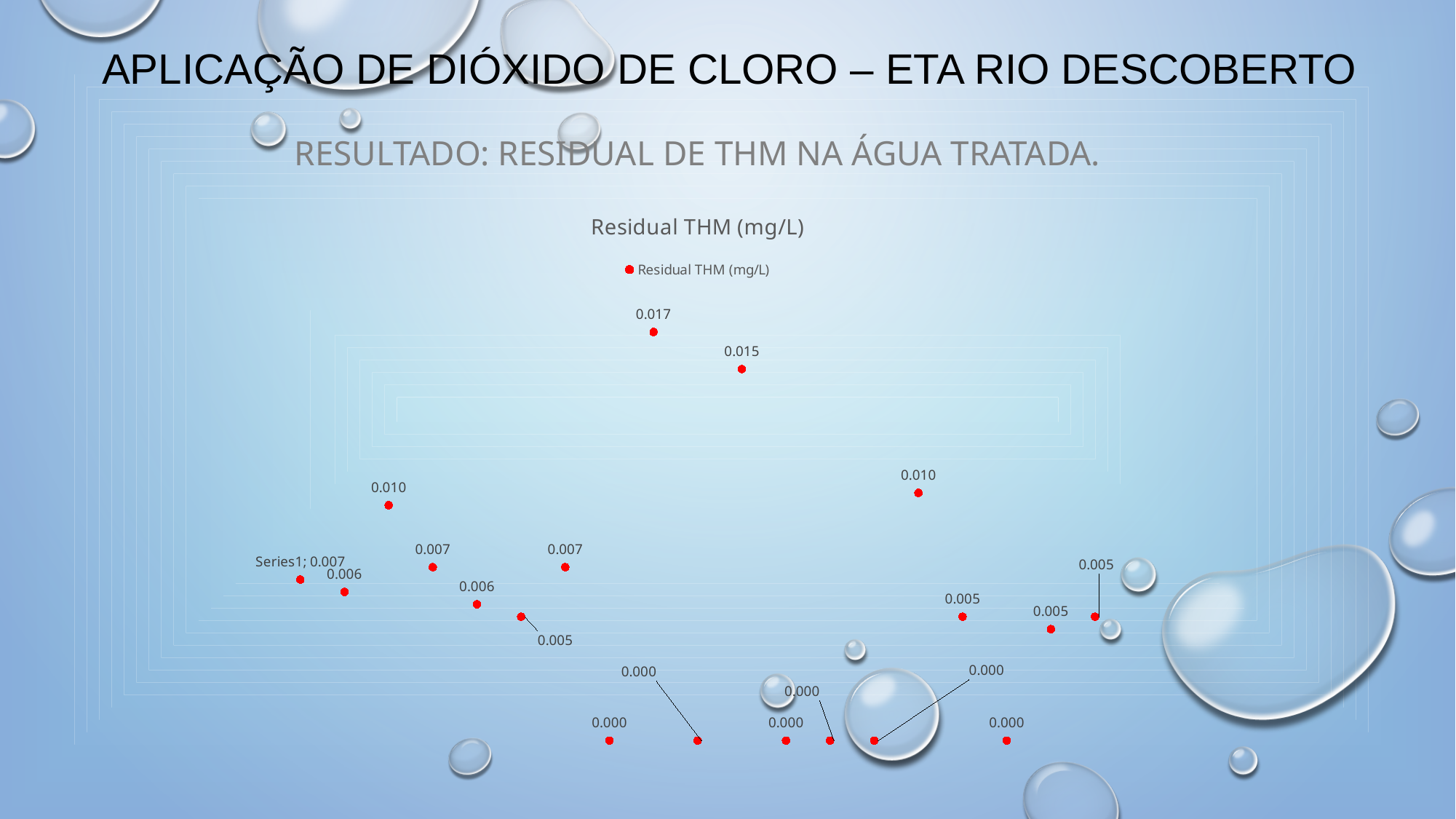
How many series does the chart legend list? 1 What is the lowest value plotted on the chart? 0.000 What is the difference between the highest value (0.017) and the second highest value (0.015) on the chart? 0.002 What is the title of the chart? Residual THM (mg/L) How many data points are plotted on the chart? 19 How many data points on the chart are labelled 0.000? 6 What value is shown for the point labelled 'Series1' on the chart? 0.007 Which is larger: the value of the first point on the left (0.007) or the value of the last point on the right (0.005)? the first point (0.007) What colour are the data point markers on the chart? red What is the highest value plotted on the chart? 0.017 What kind of chart is shown on the slide? scatter chart What is the difference between the highest value on the chart and the lowest value on the chart? 0.017